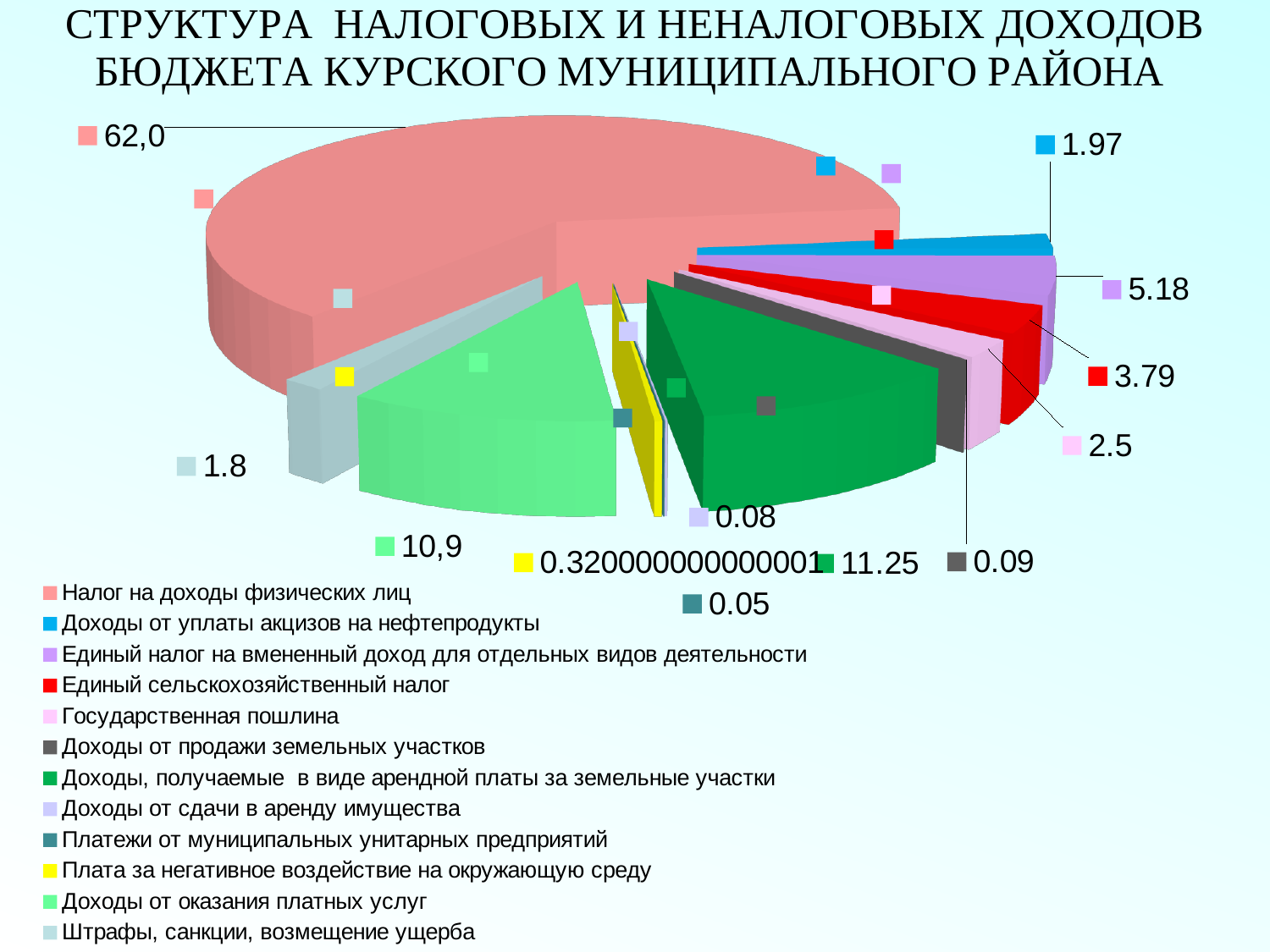
What is the difference between the values for Единый налог на вмененный доход для отдельных видов деятельности and Единый сельскохозяйственный налог? 1.39 What is the value for Платежи от муниципальных унитарных предприятий? 0.05 What kind of chart is shown on the slide? pie chart How many categories does the legend list? 12 What is the value for Доходы, получаемые в виде арендной платы за земельные участки? 11.25 Which category has the largest slice of the pie? Налог на доходы физических лиц What is the value for Единый налог на вмененный доход для отдельных видов деятельности? 5.18 What is the value for Доходы от оказания платных услуг? 10,9 What is the value for Налог на доходы физических лиц? 62,0 What colour is the slice for Плата за негативное воздействие на окружающую среду? yellow Which is larger: the value for Государственная пошлина or the value for Доходы от уплаты акцизов на нефтепродукты? Государственная пошлина Which category has the smallest value? Платежи от муниципальных унитарных предприятий